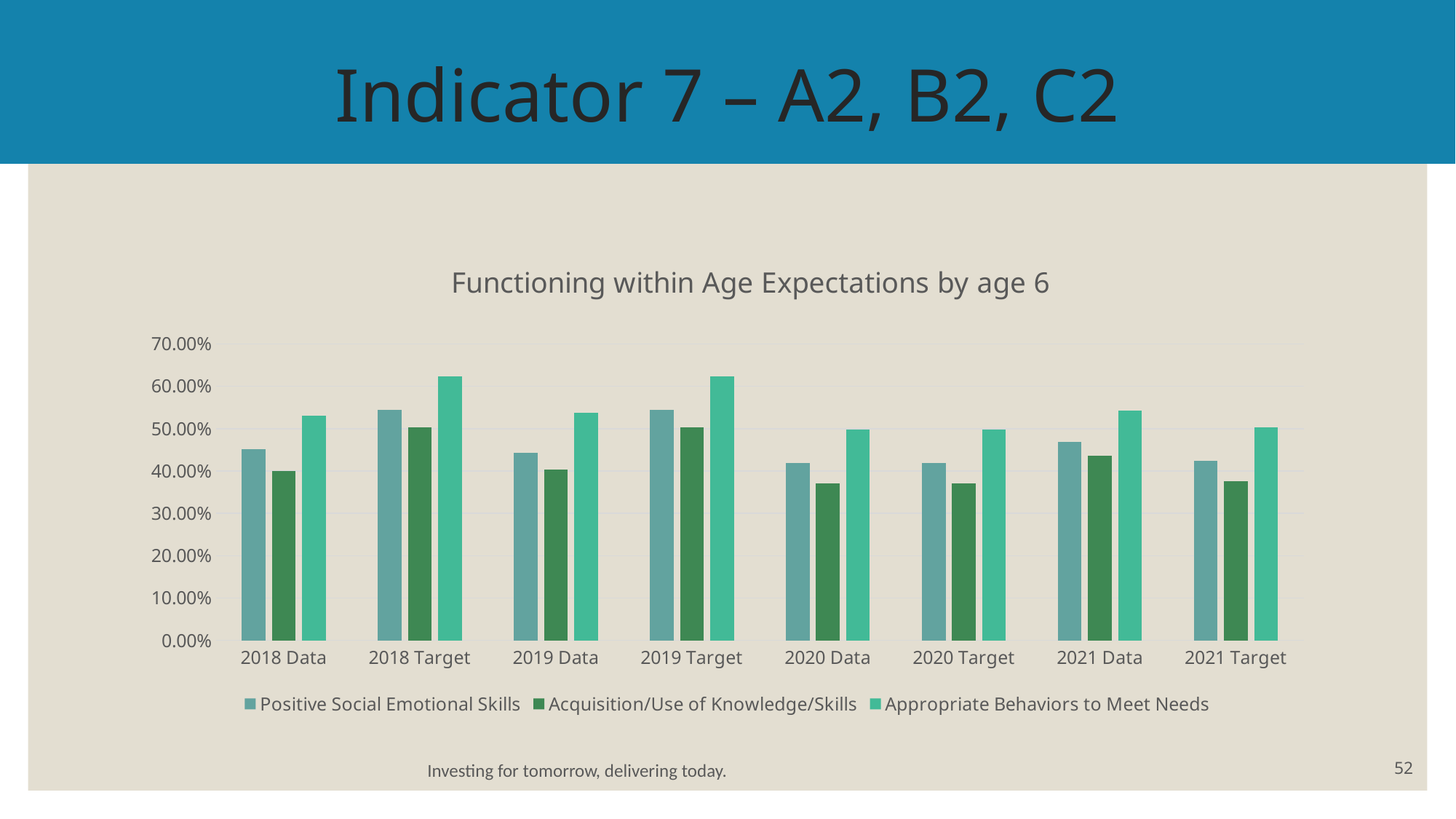
Which series has the highest value in the 2018 Data group? Appropriate Behaviors to Meet Needs How many categories are shown on the x axis? 8 What is the title of the chart? Functioning within Age Expectations by age 6 For Appropriate Behaviors to Meet Needs, which is larger: 2018 Data or 2018 Target? 2018 Target How many series does the legend list? 3 What type of chart is shown on the slide? bar chart Which series has the lowest value in the 2021 Data group? Acquisition/Use of Knowledge/Skills For Positive Social Emotional Skills, which is larger: 2021 Data or 2021 Target? 2021 Data Is the value for Positive Social Emotional Skills in 2018 Data greater or less than 40.00%? greater Is the value for Positive Social Emotional Skills in 2019 Target greater or less than 50.00%? greater Is the value for Appropriate Behaviors to Meet Needs in 2018 Target greater or less than 60.00%? greater